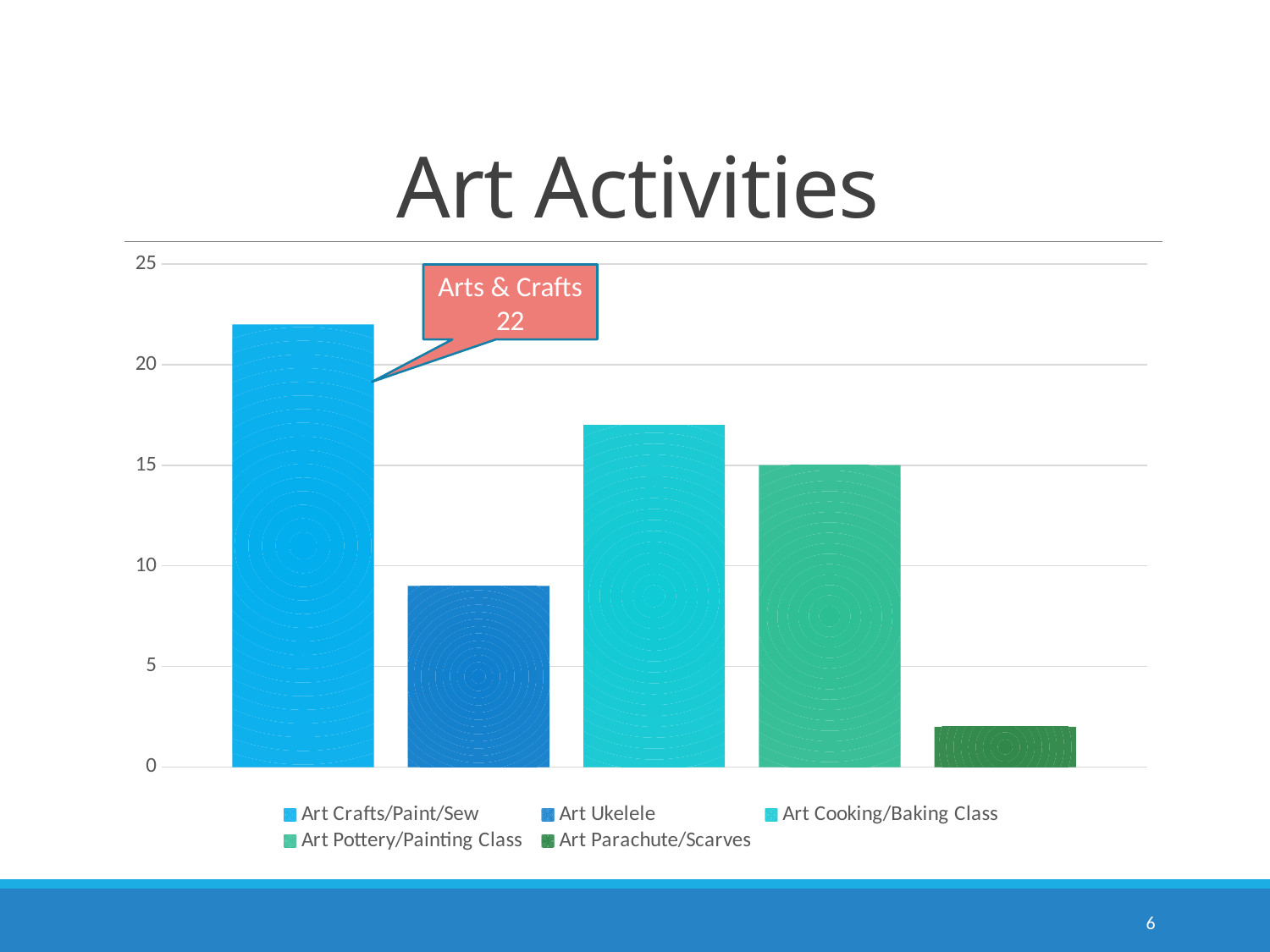
Is the value for Art Ukelele greater or less than 10? less What kind of chart is shown on the slide? Bar chart Is the value for Art Parachute/Scarves greater or less than 5? less How many entries does the legend of the Art Activities chart list? 5 Is the value for Art Cooking/Baking Class greater or less than 15? greater What is the title of the chart on the slide? Art Activities Which is larger, the bar for Art Cooking/Baking Class or the bar for Art Pottery/Painting Class? Art Cooking/Baking Class What value is shown for Art Crafts/Paint/Sew in the Art Activities chart? 22 What text appears in the callout pointing to the tallest bar? Arts & Crafts 22 Which category has the highest bar in the Art Activities chart? Art Crafts/Paint/Sew Which category has the lowest bar in the Art Activities chart? Art Parachute/Scarves How many bars are plotted in the Art Activities chart? 5